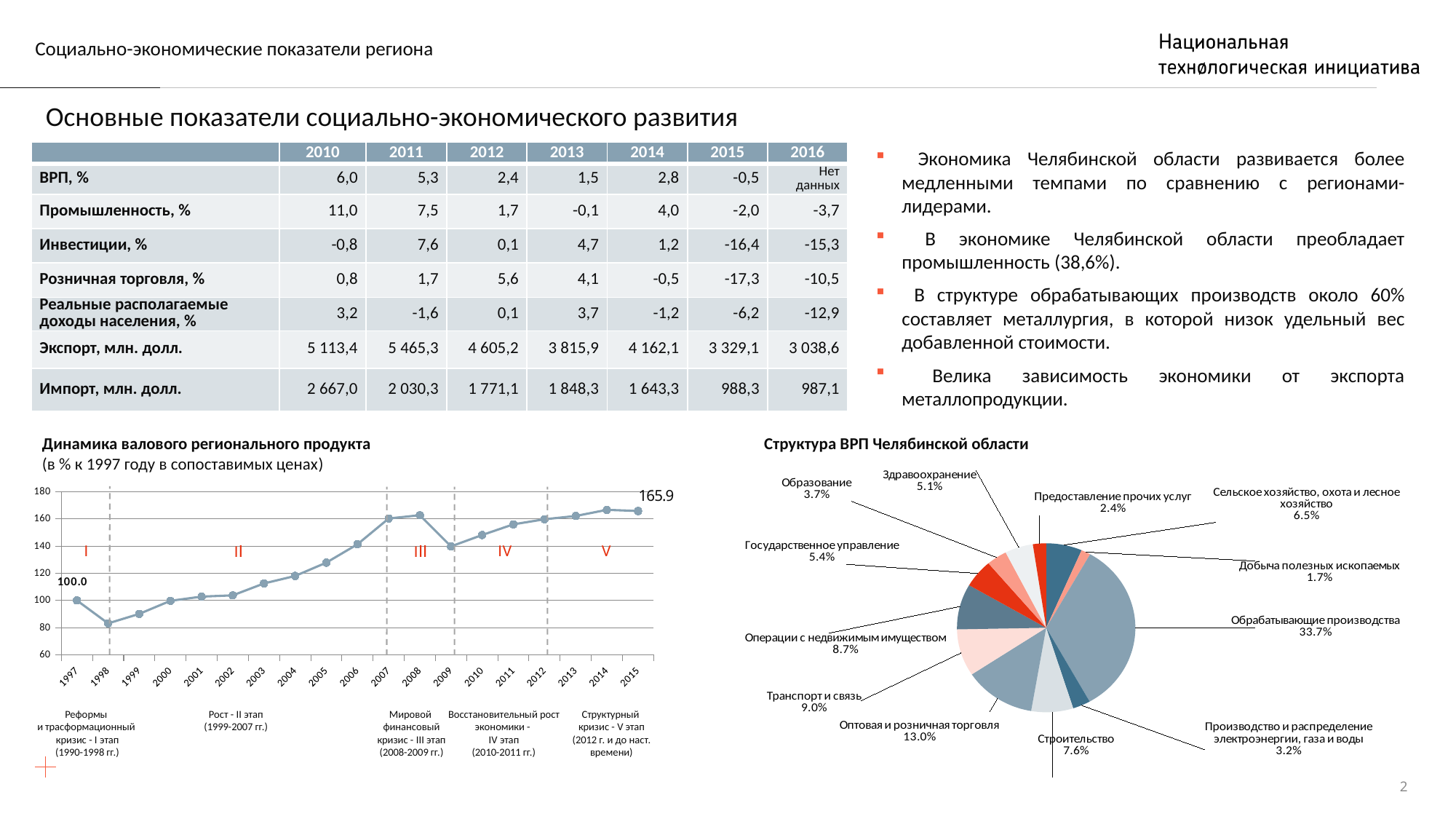
What kind of chart is 'Динамика валового регионального продукта'? Line chart On the pie chart 'Структура ВРП Челябинской области', which sector has the largest share? Обрабатывающие производства On the line chart 'Динамика валового регионального продукта', do the values rise or fall from 2009 to 2014? rise On the line chart 'Динамика валового регионального продукта', is the value for 1998 greater or less than 100? less On the line chart 'Динамика валового регионального продукта', what is the value for 2015? 165.9 On the line chart 'Динамика валового регионального продукта', how many years are plotted on the x axis? 19 On the line chart 'Динамика валового регионального продукта', is the value for 2007 greater or less than 140? greater On the pie chart 'Структура ВРП Челябинской области', which sector has the smallest share? Добыча полезных ископаемых On the pie chart 'Структура ВРП Челябинской области', how many slices are there? 12 On the line chart 'Динамика валового регионального продукта', what is the value for 1997? 100.0 On the pie chart 'Структура ВРП Челябинской области', what is the share of 'Оптовая и розничная торговля'? 13.0% On the line chart 'Динамика валового регионального продукта', which year has the larger value, 2008 or 2009? 2008